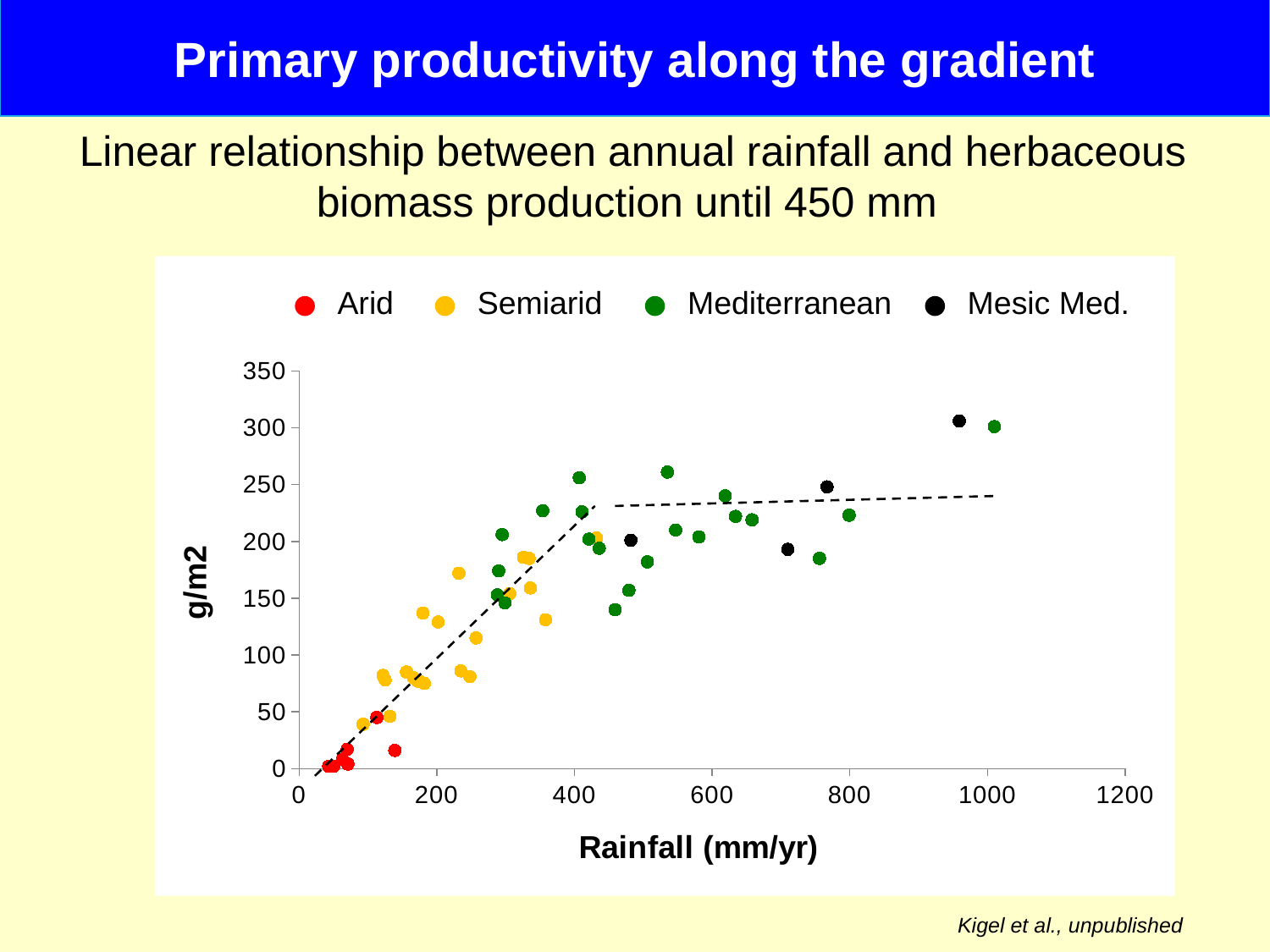
Which series has the lowest biomass values on the chart? Arid Is the highest Mediterranean point greater or less than 250 g/m2? greater What kind of chart is shown on the slide? Scatter chart Which series occupies the lowest rainfall range on the x axis? Arid Is the highest Semiarid point greater or less than 150 g/m2? greater Is the lowest Mesic Med. point greater or less than 150 g/m2? greater What are the four series named in the legend? Arid, Semiarid, Mediterranean, Mesic Med. What is the maximum value shown on the y axis? 350 What is the label of the x axis? Rainfall (mm/yr) Do biomass values generally rise or fall as rainfall increases from 0 to 400 mm/yr? rise How many series does the legend list? 4